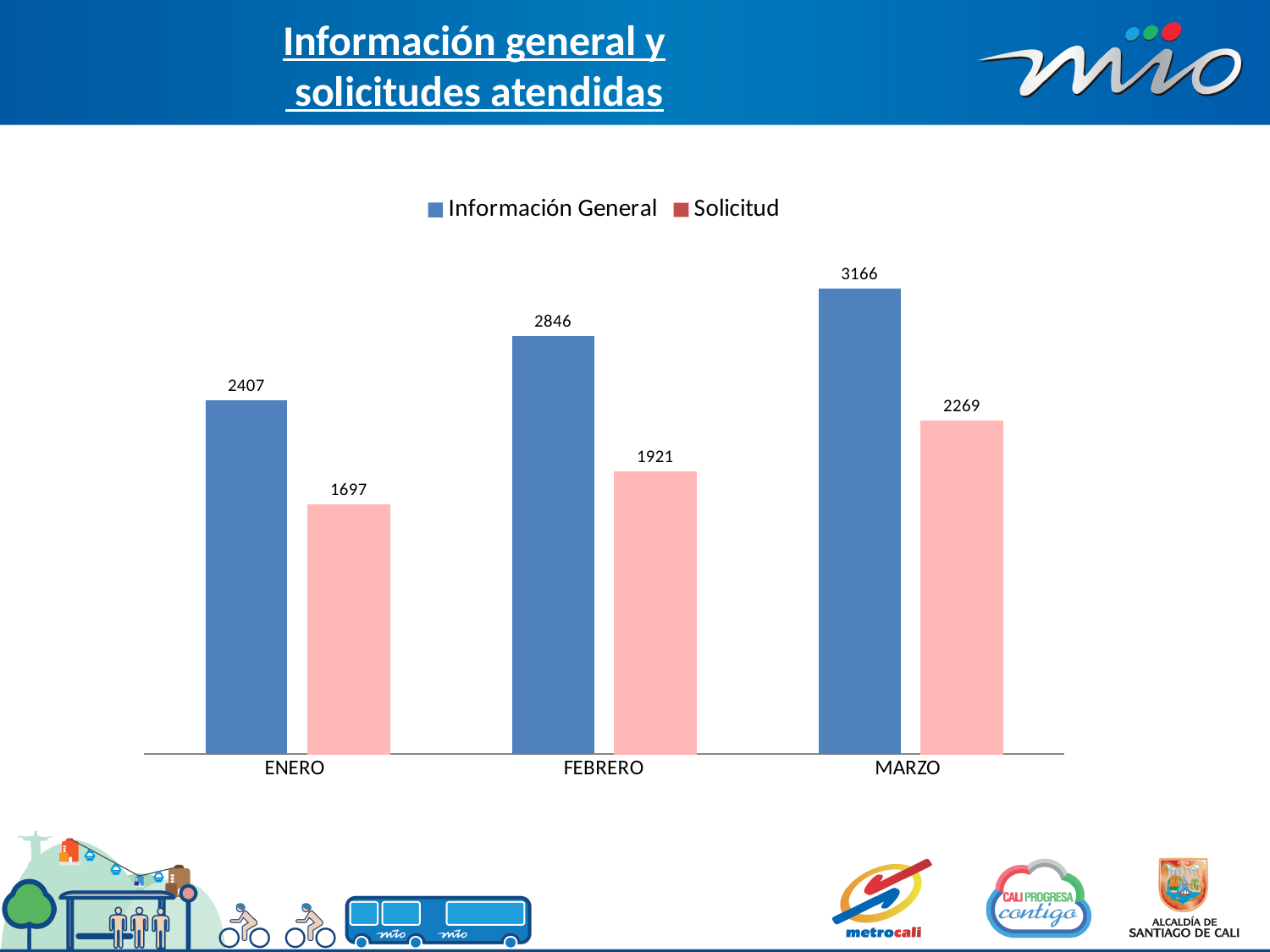
How many series does the legend list? 2 What kind of chart is shown on the slide? Bar chart How many months are shown on the x axis? 3 What is the value of Solicitud for ENERO? 1697 What is the value of Solicitud for FEBRERO? 1921 What is the value of Información General for MARZO? 3166 What is the difference between Información General and Solicitud in MARZO? 897 Which month has the lowest value for Solicitud? ENERO What is the value of Información General for ENERO? 2407 Which month has the highest value for Información General? MARZO Do the Solicitud values rise or fall from ENERO to MARZO? Rise Which is larger in FEBRERO, Información General or Solicitud? Información General